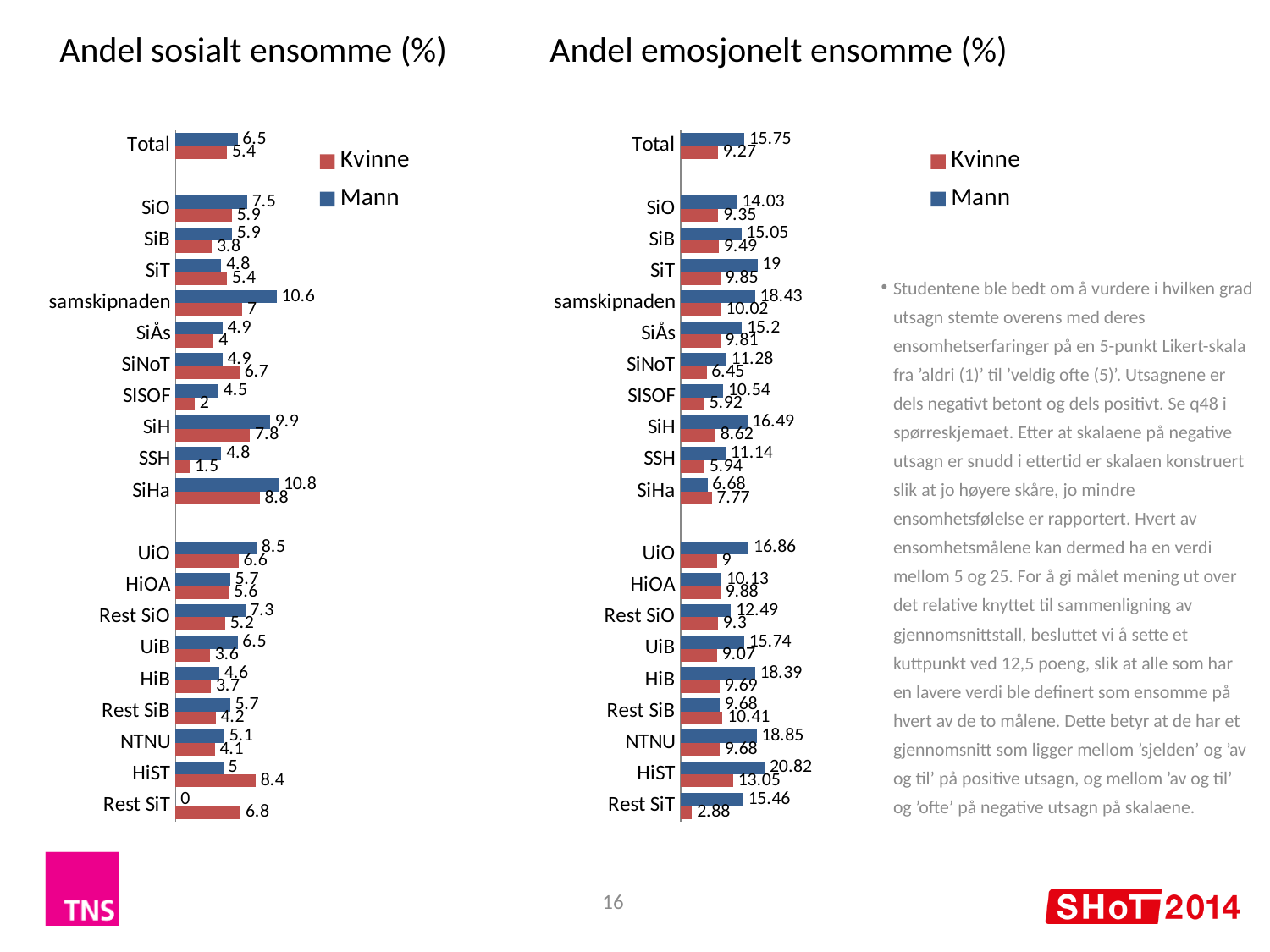
In the 'Andel emosjonelt ensomme (%)' chart, which is larger for SiHa, the Mann value or the Kvinne value? Kvinne In the 'Andel sosialt ensomme (%)' chart, what is the value for Kvinne for HiST? 8.4 In the 'Andel sosialt ensomme (%)' chart, which category has the highest value for Mann? SiHa In the 'Andel emosjonelt ensomme (%)' chart, what is the value for Mann for Total? 15.75 In the 'Andel emosjonelt ensomme (%)' chart, what is the value for Kvinne for Rest SiT? 2.88 In the 'Andel emosjonelt ensomme (%)' chart, which category has the highest value for Mann? HiST In the 'Andel sosialt ensomme (%)' chart, what is the difference between the Mann and Kvinne values for SiH? 2.1 How many series does the legend of the 'Andel sosialt ensomme (%)' chart list? 2 What type of chart is 'Andel emosjonelt ensomme (%)'? Bar chart In the 'Andel emosjonelt ensomme (%)' chart, what is the difference between the Mann and Kvinne values for SiT? 9.15 In the 'Andel sosialt ensomme (%)' chart, what is the value for Mann for samskipnaden? 10.6 In the 'Andel sosialt ensomme (%)' chart, which category has the lowest value for Kvinne? SSH